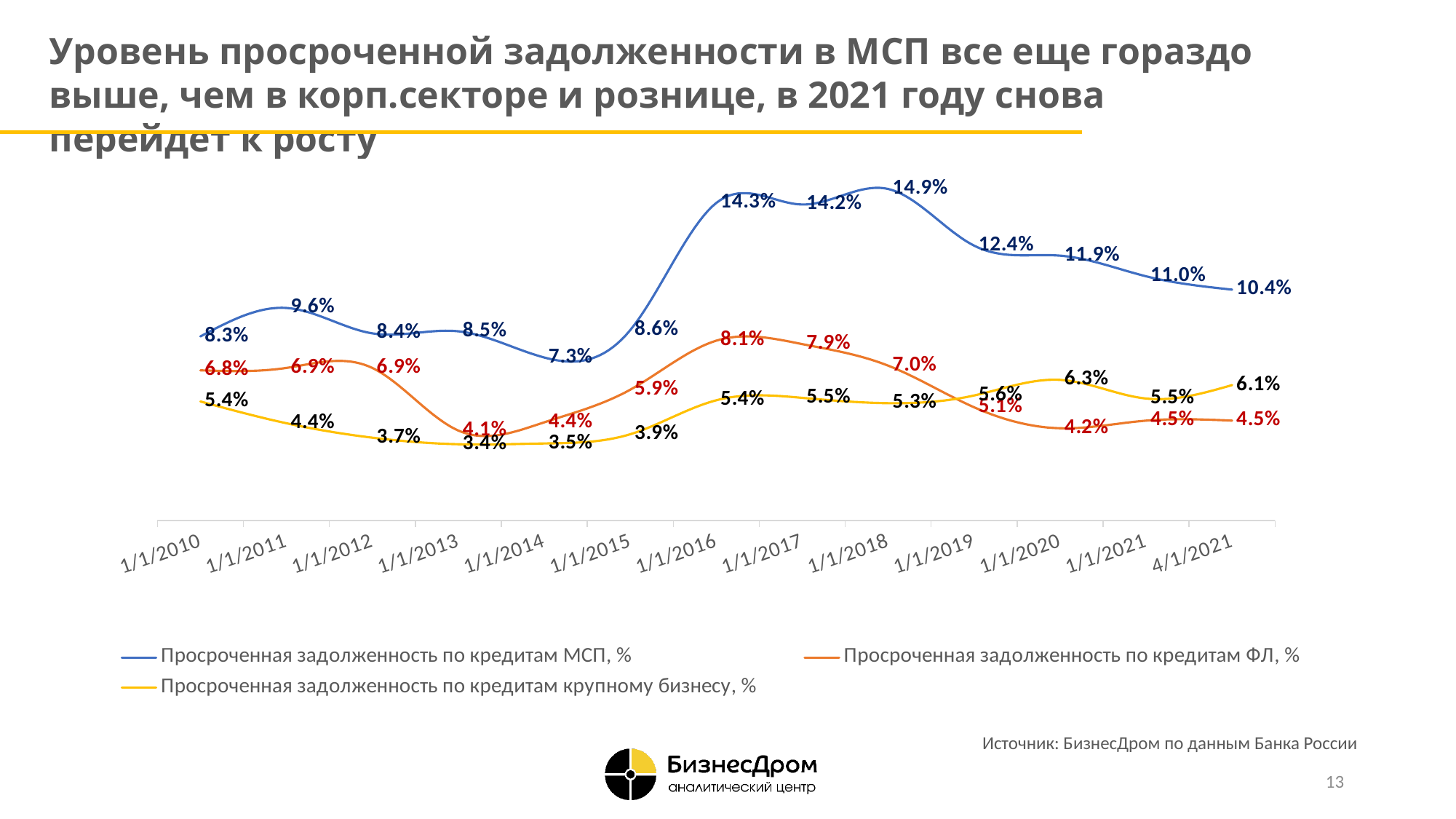
At 1/1/2020, which is larger: the ФЛ series or the крупному бизнесу series? Просроченная задолженность по кредитам крупному бизнесу, % Which colour is used for the 'Просроченная задолженность по кредитам МСП, %' line? blue How many series does the legend list? 3 What is the value of 'Просроченная задолженность по кредитам ФЛ, %' at 1/1/2017? 7.9% What type of chart is shown on the slide? line chart At which date does 'Просроченная задолженность по кредитам МСП, %' reach its highest value? 1/1/2018 Does 'Просроченная задолженность по кредитам МСП, %' rise or fall from 1/1/2018 to 4/1/2021? fall What is the difference between the МСП series and the ФЛ series at 4/1/2021? 5.9% What is the value of 'Просроченная задолженность по кредитам МСП, %' at 1/1/2018? 14.9% At which date is 'Просроченная задолженность по кредитам крупному бизнесу, %' at its lowest? 1/1/2013 How many dates are shown on the x axis? 13 What is the value of 'Просроченная задолженность по кредитам крупному бизнесу, %' at 1/1/2013? 3.4%